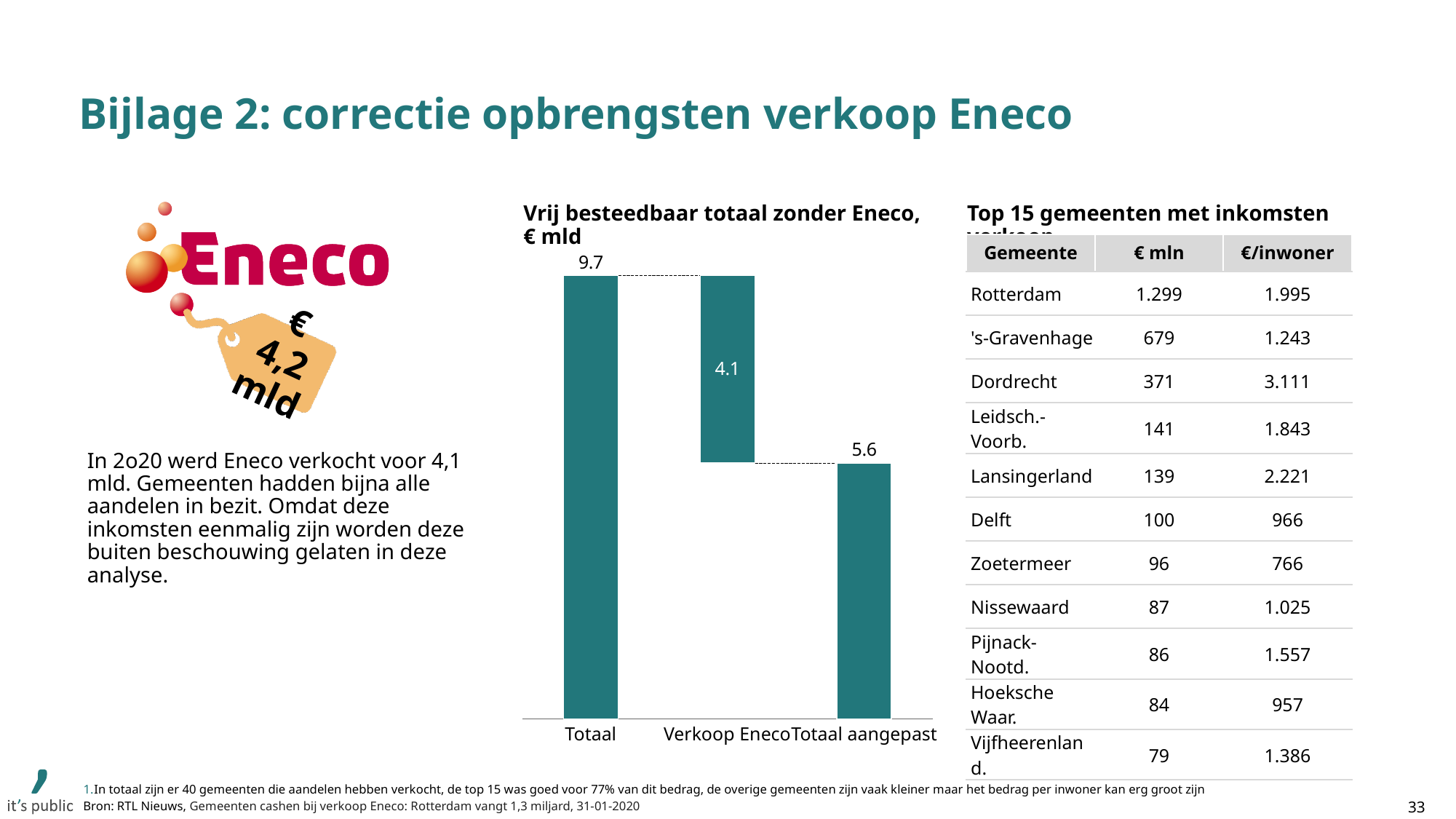
How many categories are shown on the x axis of the chart? 3 Which category in the chart has the lowest value? Verkoop Eneco What is the difference between the values for Totaal and Verkoop Eneco in the chart? 5.6 Which category in the chart has the highest value? Totaal What is the difference between the values for Totaal and Totaal aangepast in the chart? 4.1 What is the value for Verkoop Eneco in the chart? 4.1 Does the value fall or rise from Totaal to Totaal aangepast in the chart? Fall What is the value for Totaal in the chart 'Vrij besteedbaar totaal zonder Eneco, € mld'? 9.7 Which is larger in the chart, the value for Totaal aangepast or the value for Verkoop Eneco? Totaal aangepast What is the value for Totaal aangepast in the chart? 5.6 What is the title of the chart on the slide? Vrij besteedbaar totaal zonder Eneco, € mld What kind of chart is shown on the slide? Bar chart